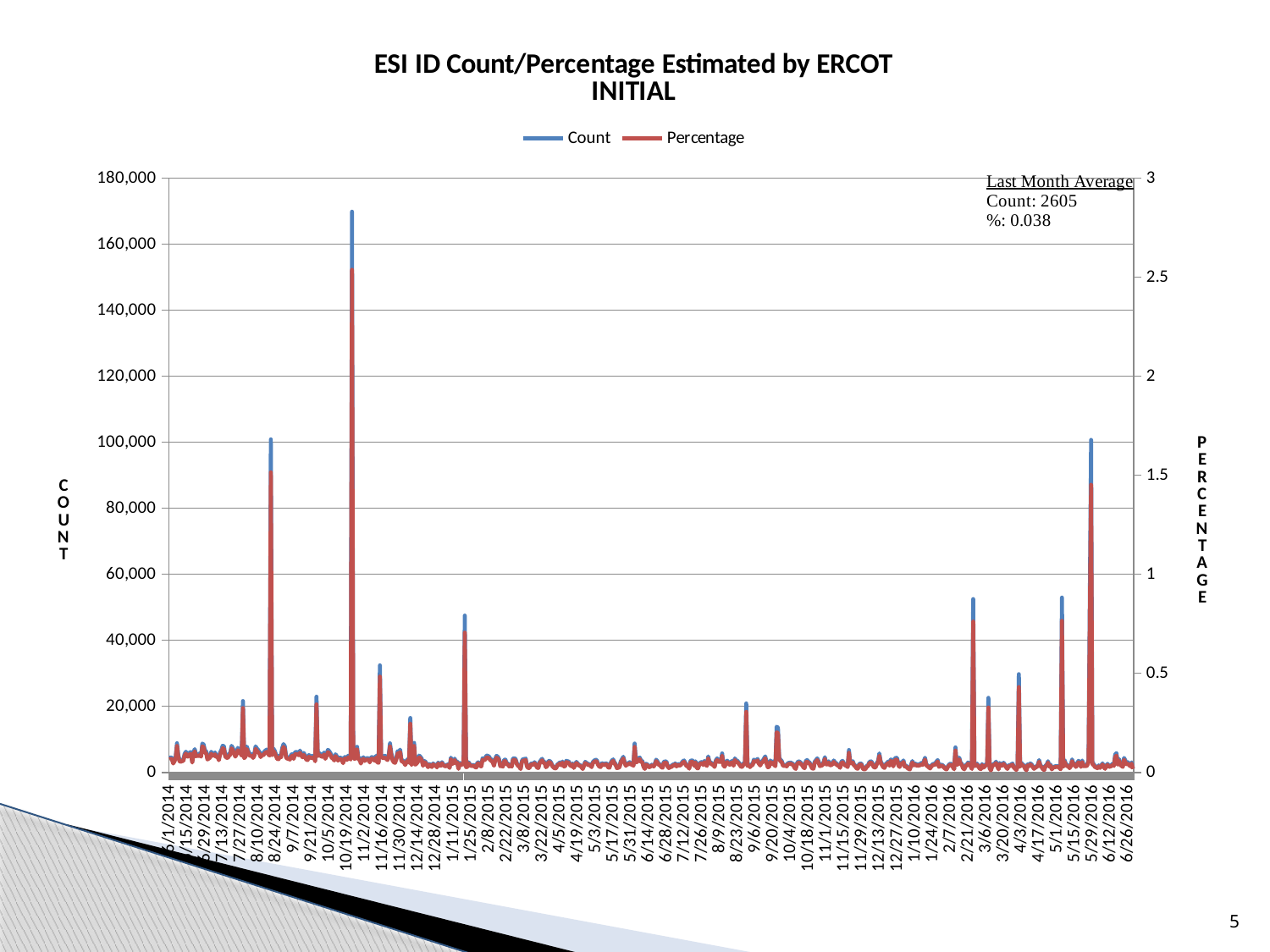
What are the two series named in the legend? Count and Percentage Near which x-axis date label does the Count series reach its highest peak? 10/19/2014 Is the highest peak of the Percentage series greater or less than 2 on the right-hand axis? greater What kind of chart is shown on the slide? line chart What is the Last Month Average percentage (%) shown in the text box on the chart? 0.038 What is the Last Month Average Count shown in the text box on the chart? 2605 What is the title of the chart? ESI ID Count/Percentage Estimated by ERCOT INITIAL How many series does the legend list? 2 Is the Count peak near 8/24/2014 greater or less than 80,000? greater Is the Count peak near 5/29/2016 greater or less than 60,000? greater Which is larger, the Count peak near 10/19/2014 or the Count peak near 1/25/2015? the peak near 10/19/2014